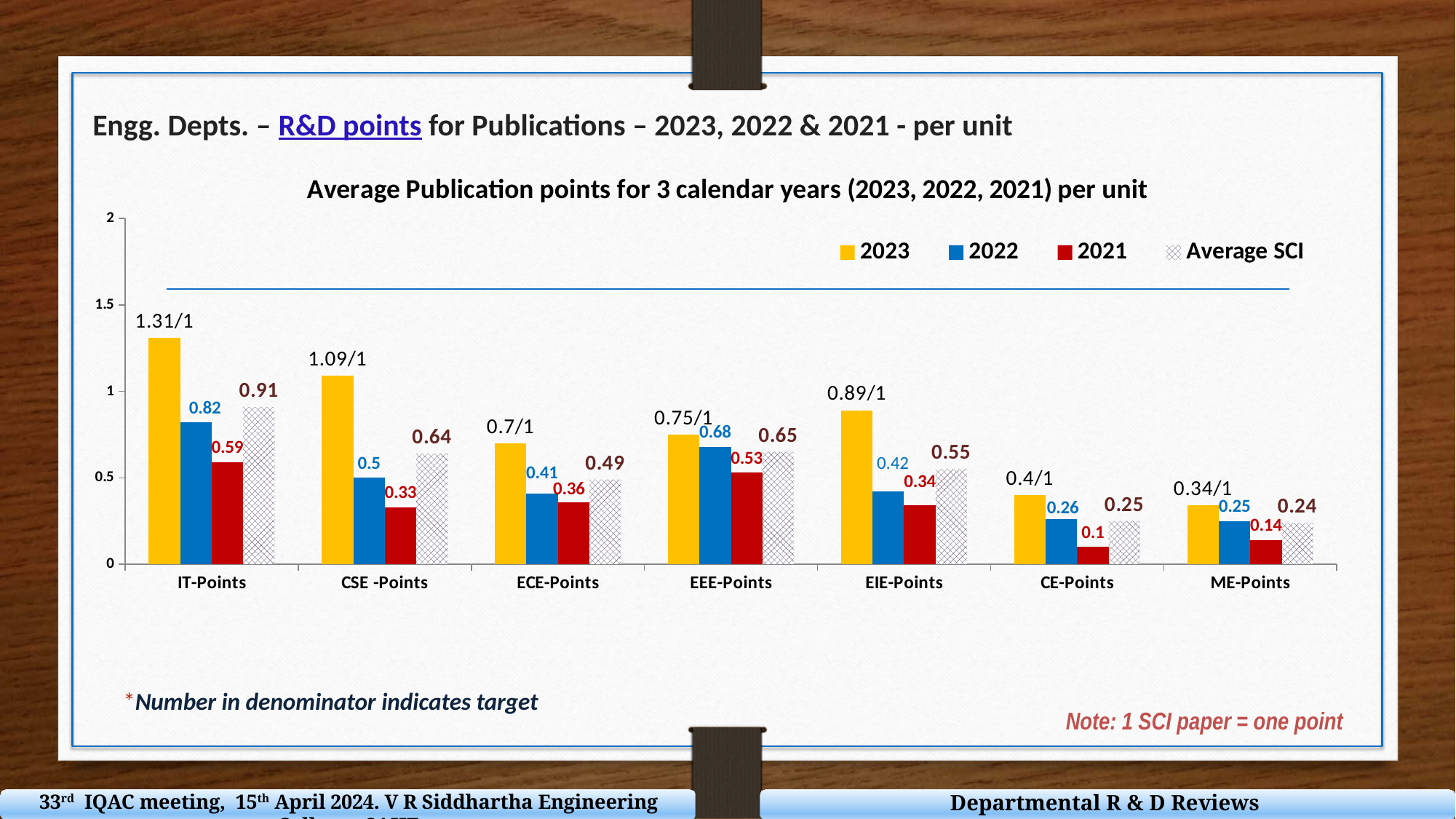
What is the 2023 data label shown for CSE -Points? 1.09/1 What is the difference between the 2022 values for IT-Points and CSE -Points? 0.32 What is the 2022 value for IT-Points? 0.82 What is the title of the chart? Average Publication points for 3 calendar years (2023, 2022, 2021) per unit What is the Average SCI value for EEE-Points? 0.65 Which is larger, the 2021 value for EEE-Points or the 2021 value for EIE-Points? EEE-Points Which department has the highest 2023 value? IT-Points How many series does the legend list? 4 How many departments (categories) are shown on the x axis? 7 What is the 2021 value for CE-Points? 0.1 Which department has the lowest 2021 value? CE-Points What kind of chart is shown on the slide? Bar chart